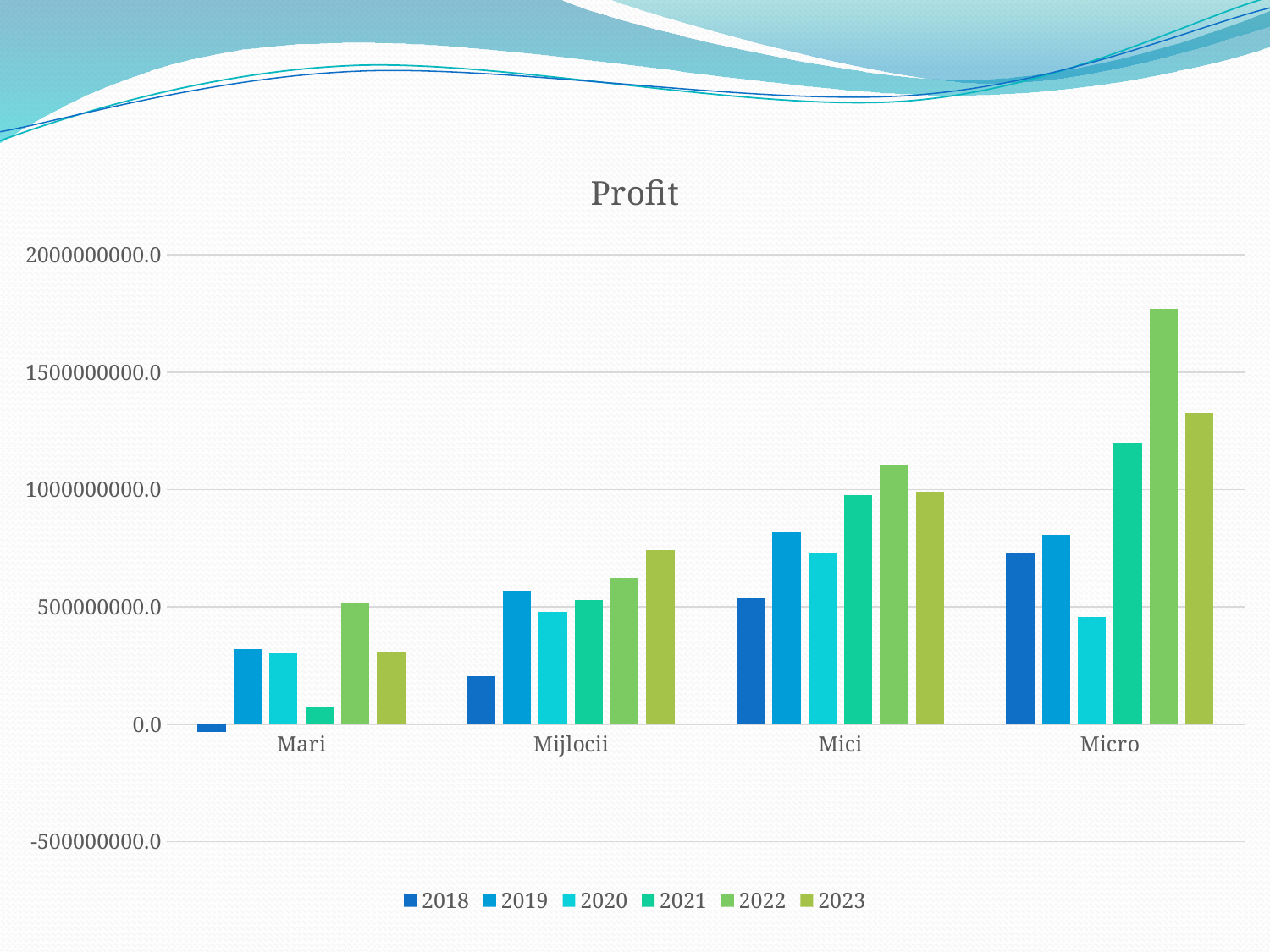
Which category has the tallest bar in the chart? Micro What kind of chart is shown on the slide? bar chart Is the value for Mici in 2022 greater or less than 1000000000.0? greater How many categories are shown on the x axis of the chart? 4 Is the value for Mari in 2018 greater or less than 0.0? less How many series does the legend list? 6 Which year has the lowest value for Micro? 2020 Which is larger for Mari: the value for 2019 or the value for 2021? 2019 What is the title of the chart? Profit Is the value for Micro in 2022 greater or less than 1500000000.0? greater Which year has the lowest value for Mari? 2018 Which year has the highest value for Micro? 2022